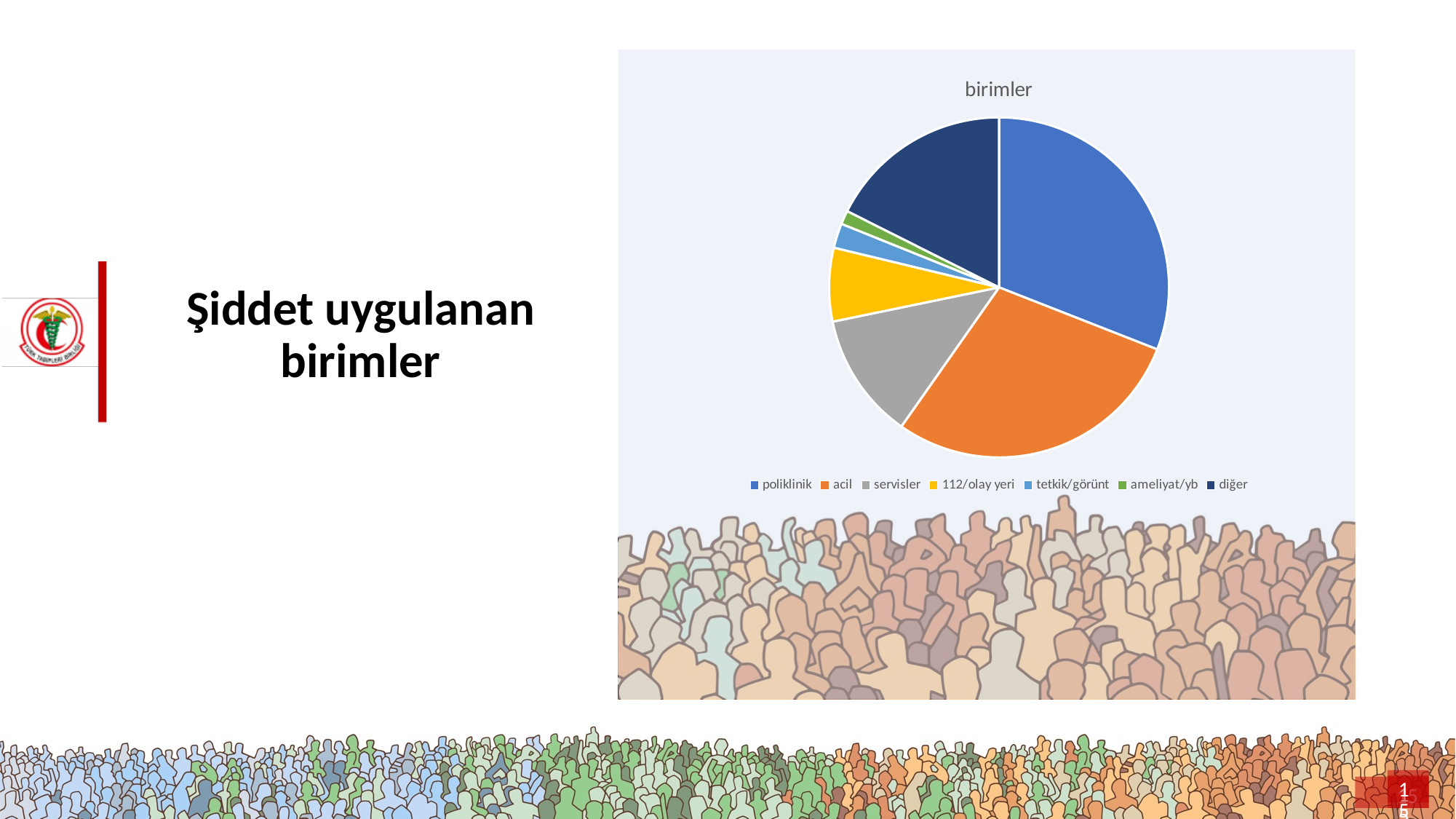
What kind of chart is shown on the slide? pie chart Which slice is larger, servisler or 112/olay yeri? servisler How many categories does the pie chart have? 7 Which slice is larger, poliklinik or servisler? poliklinik What is the title of the chart? birimler Which slice is larger, acil or diğer? acil What colour is the acil slice in the pie chart? orange Which category has the smallest slice of the pie? ameliyat/yb How many entries does the legend list? 7